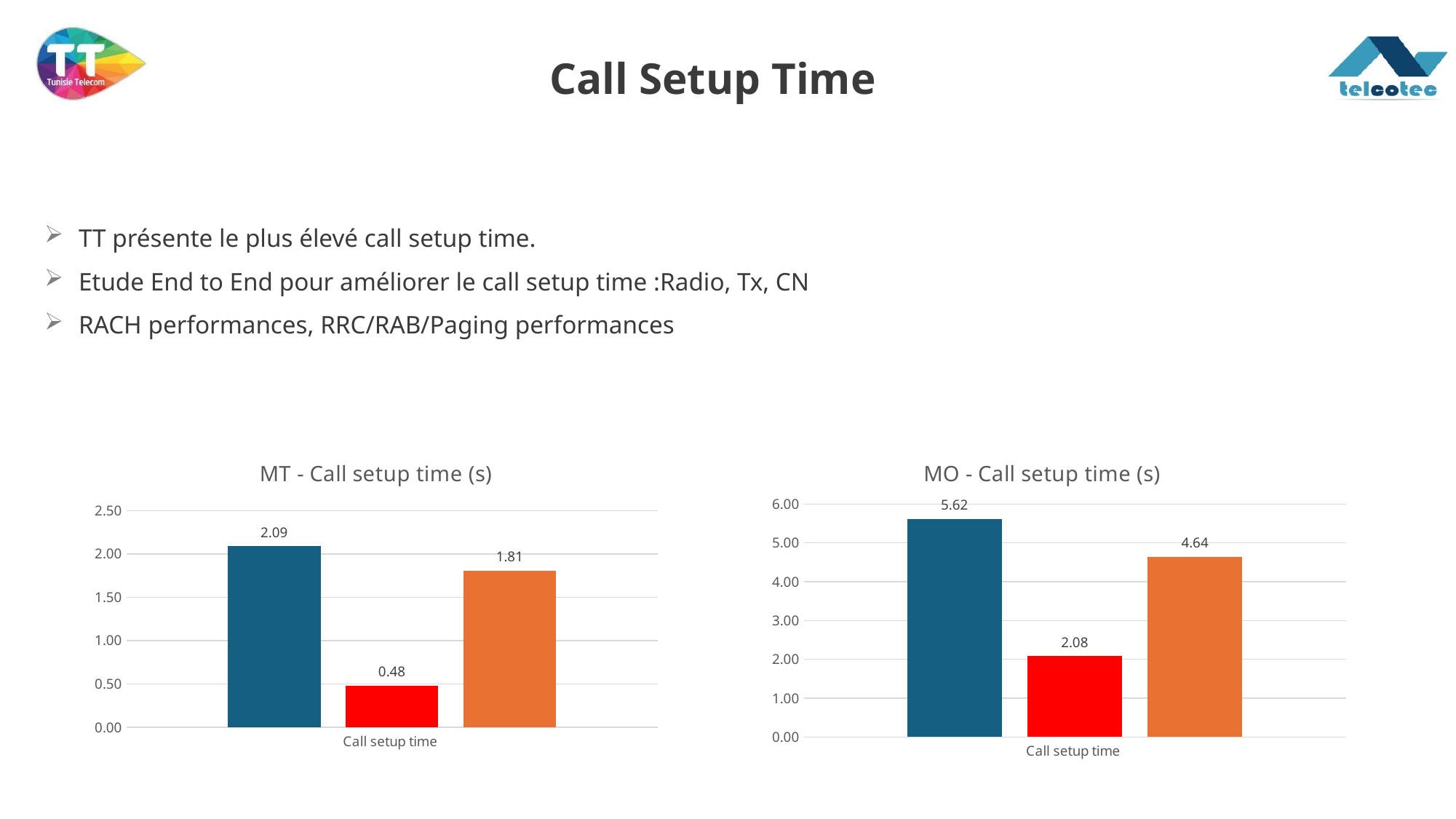
In the 'MT - Call setup time (s)' chart, what is the value of the red bar? 0.48 In the 'MO - Call setup time (s)' chart, what is the difference between the blue bar and the red bar? 3.54 What is the title of the chart on the left side of the slide? MT - Call setup time (s) In the 'MO - Call setup time (s)' chart, what is the value of the blue bar? 5.62 In the 'MT - Call setup time (s)' chart, which bar is the lowest? The red bar (0.48) In the 'MO - Call setup time (s)' chart, is the orange bar larger or smaller than the red bar? Larger In the 'MO - Call setup time (s)' chart, which bar is the highest? The blue bar (5.62) In the 'MT - Call setup time (s)' chart, what is the value of the blue bar? 2.09 How many bars are shown in the 'MT - Call setup time (s)' chart? 3 What type of chart is the 'MO - Call setup time (s)' chart? Bar chart In the 'MO - Call setup time (s)' chart, what is the value of the orange bar? 4.64 In the 'MT - Call setup time (s)' chart, what is the difference between the blue bar and the orange bar? 0.28